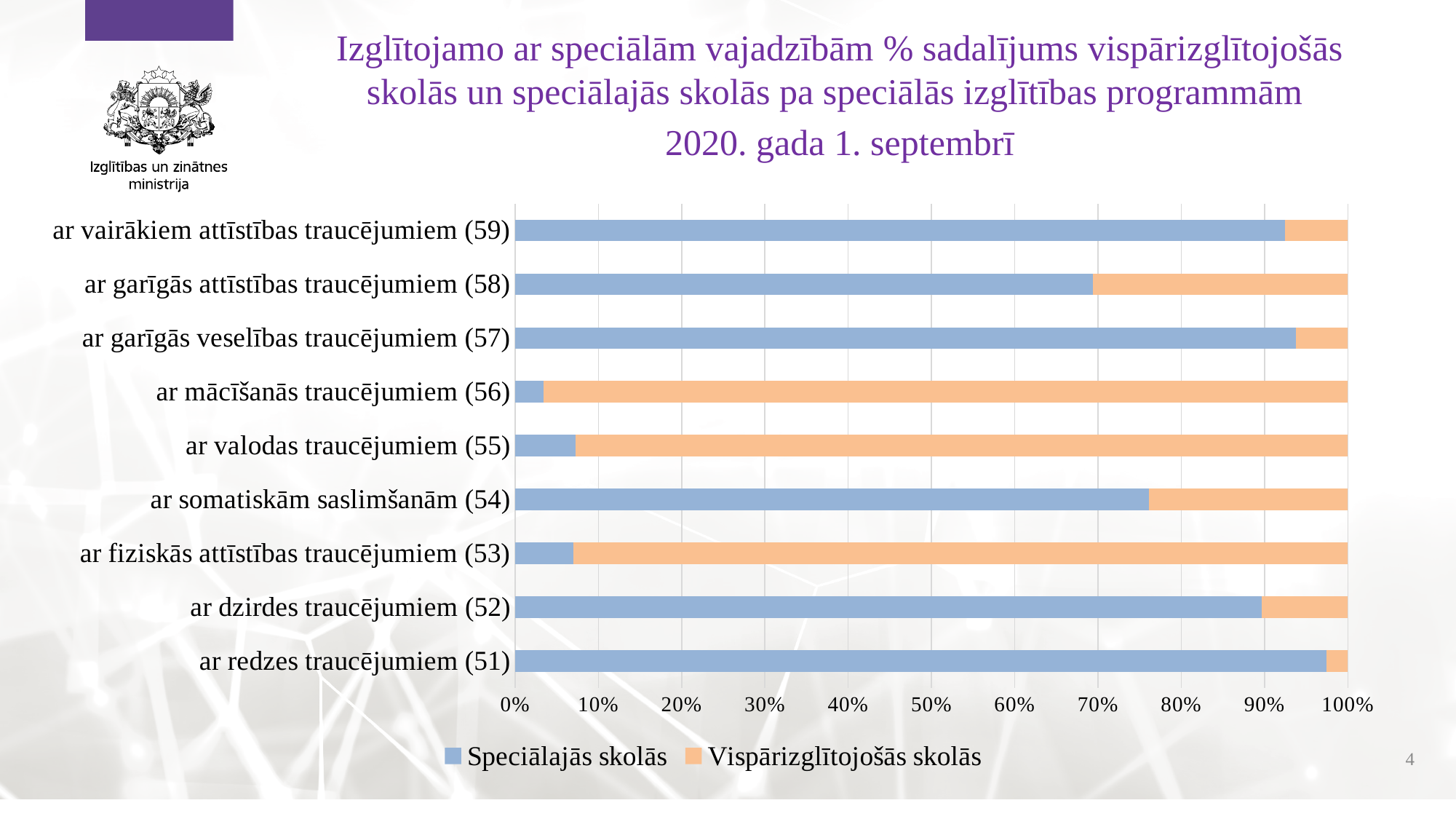
How many series does the legend list? 2 Which colour represents the Vispārizglītojošās skolās series? orange Which has a larger Speciālajās skolās share: ar garīgās attīstības traucējumiem (58) or ar somatiskām saslimšanām (54)? ar somatiskām saslimšanām (54) Is the Speciālajās skolās share for ar mācīšanās traucējumiem (56) greater or less than 10%? less Is the Speciālajās skolās share for ar garīgās attīstības traucējumiem (58) greater or less than 60%? greater How many categories (special education programmes) are plotted on the chart? 9 Which has a larger Vispārizglītojošās skolās share: ar valodas traucējumiem (55) or ar garīgās veselības traucējumiem (57)? ar valodas traucējumiem (55) Is the Speciālajās skolās share for ar somatiskām saslimšanām (54) greater or less than 70%? greater What kind of chart is shown on the slide? bar chart Which category has the highest share for Speciālajās skolās? ar redzes traucējumiem (51) Which category has the lowest share for Speciālajās skolās? ar mācīšanās traucējumiem (56)